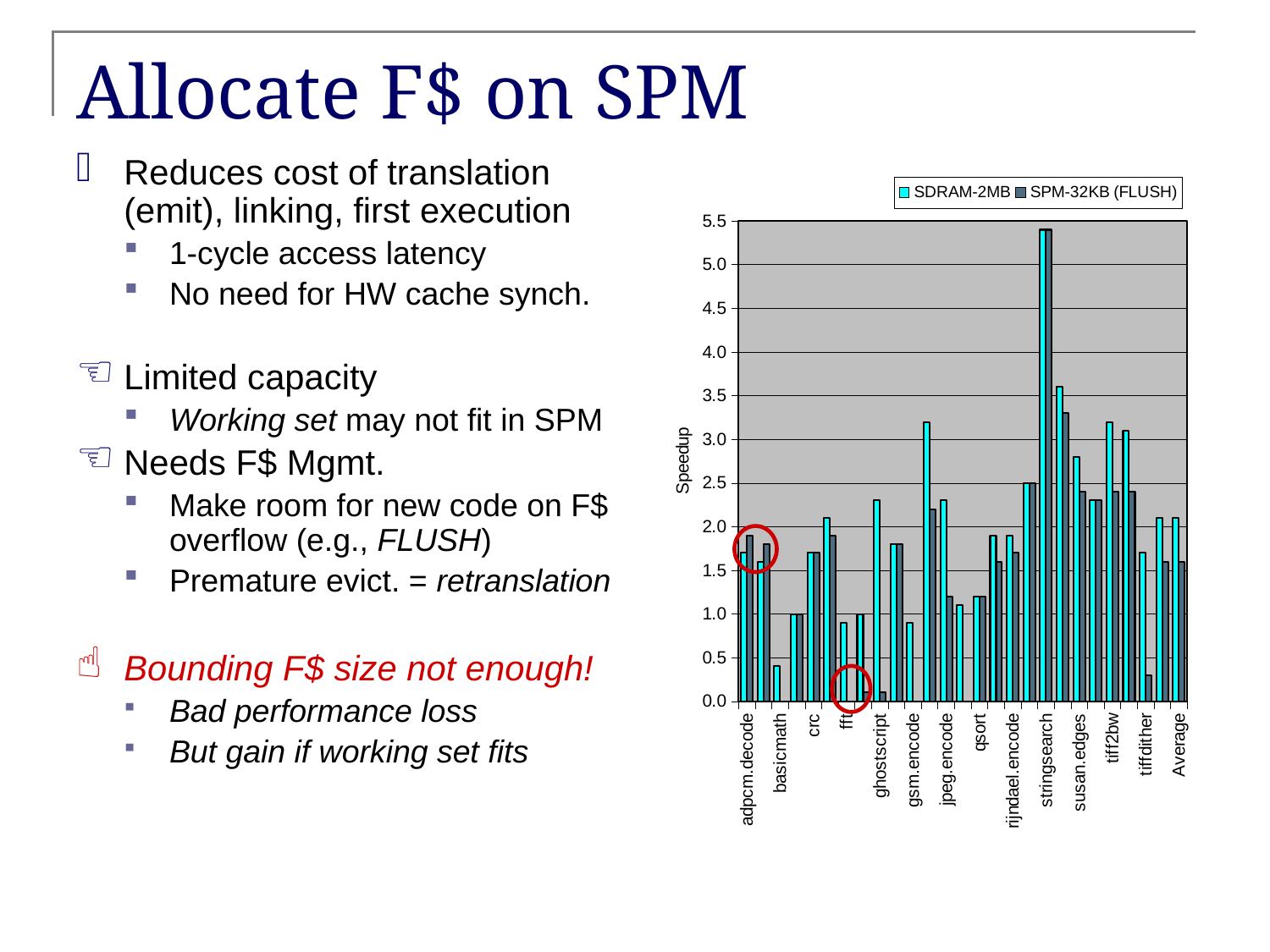
Is the SPM-32KB (FLUSH) speedup for stringsearch greater or less than 4.5? greater How many series does the chart legend list? 2 What is the label on the chart's vertical axis? Speedup Is the SPM-32KB (FLUSH) speedup for Average greater or less than 2.0? less What are the two series named in the chart legend? SDRAM-2MB and SPM-32KB (FLUSH) Is the SDRAM-2MB speedup for stringsearch greater or less than 5.0? greater For Average, which series has the larger speedup, SDRAM-2MB or SPM-32KB (FLUSH)? SDRAM-2MB Which benchmark has the highest speedup in the chart? stringsearch What kind of chart is shown on the slide? bar chart